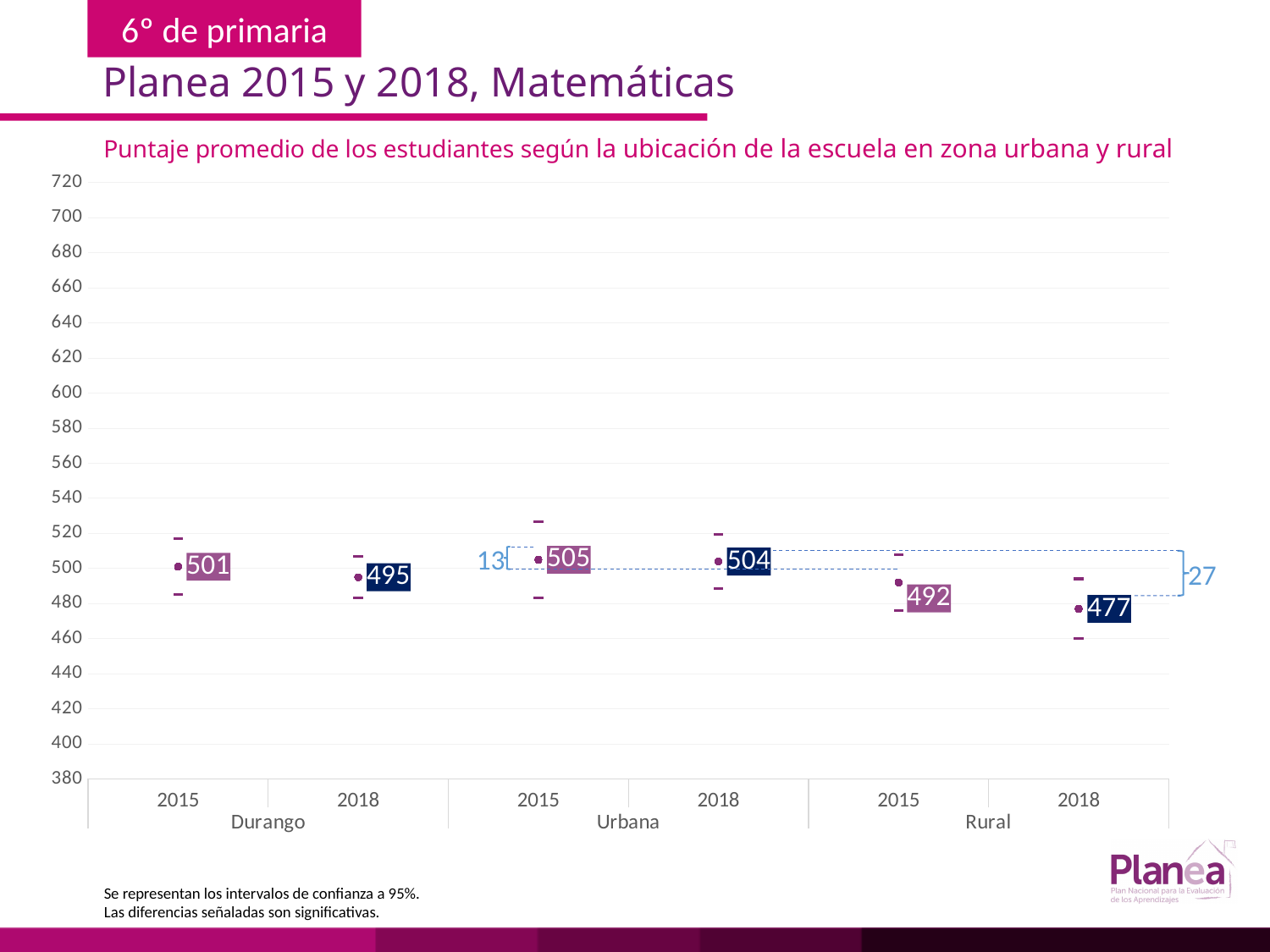
What is the average score for Durango in 2018? 495 Which is larger, the Durango 2015 score or the Rural 2015 score? Durango 2015 How many data points are plotted in the chart? 6 What is the average score for Durango in 2015? 501 What is the average score for Urbana schools in 2015? 505 What is the difference between the Rural 2015 and Rural 2018 average scores? 15 Which group and year has the lowest average score? Rural 2018 What is the difference between the Urbana 2018 and Rural 2018 average scores? 27 Did the Rural average score rise or fall from 2015 to 2018? Fall Which group and year has the highest average score? Urbana 2015 What is the average score for Rural schools in 2018? 477 What is the subtitle of the chart? Puntaje promedio de los estudiantes según la ubicación de la escuela en zona urbana y rural